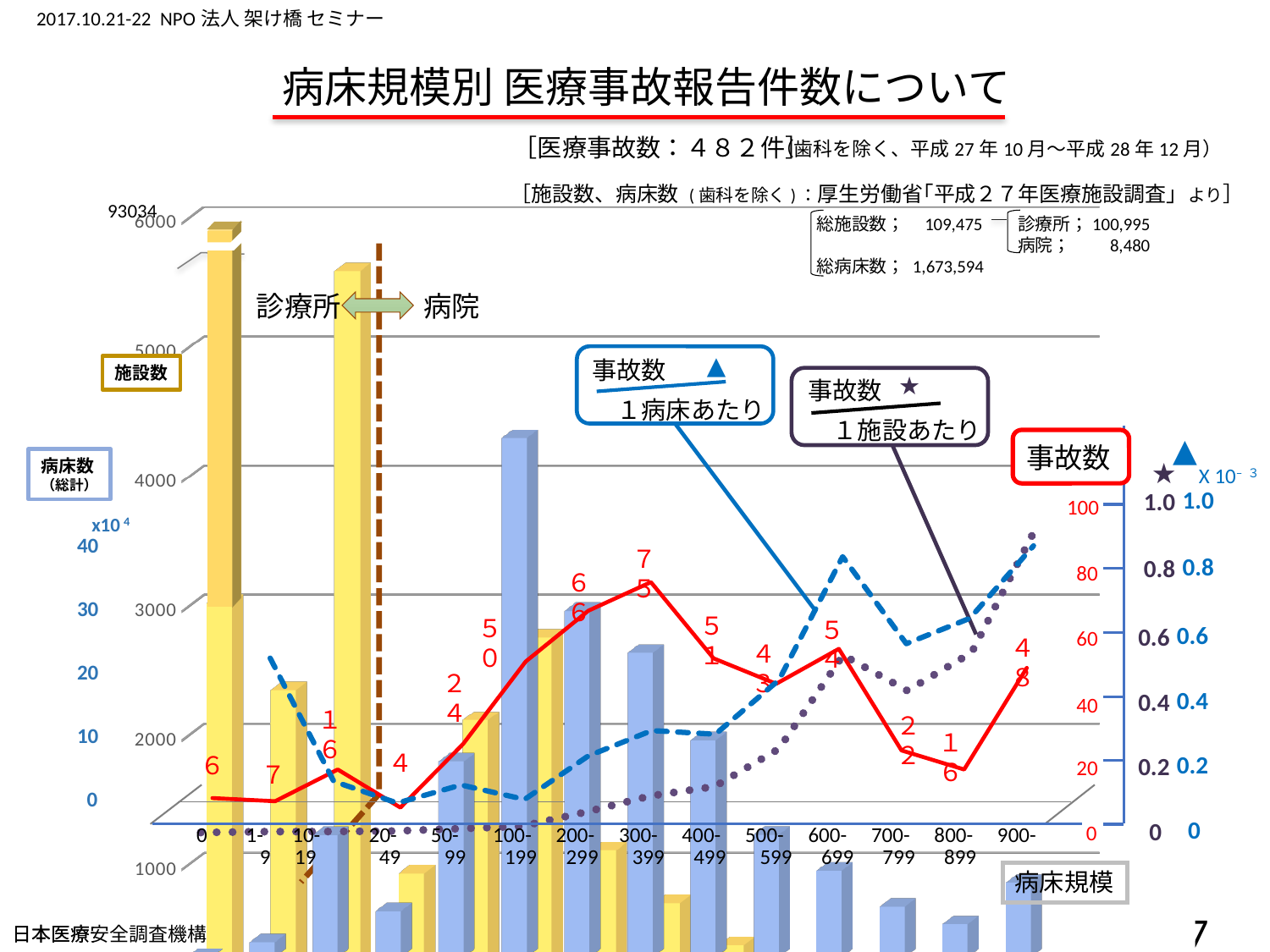
What is the number of medical accidents (事故数) for the 0 bed category? 6 Which bed-size category has the highest number of medical accidents (事故数)? 300-399 Which bed-size category has the lowest number of medical accidents (事故数)? 20-49 What is the difference in the number of medical accidents between the 300-399 and 200-299 bed categories? 9 Does the number of medical accidents rise or fall from the 300-399 category to the 500-599 category? fall What is the number of medical accidents (事故数) for the 300-399 bed category? 75 What is the difference in the number of medical accidents between the 700-799 and 800-899 bed categories? 6 Which has more medical accidents, the 100-199 bed category or the 900- bed category? 100-199 What kind of chart is used to show the number of facilities (施設数) and number of beds (病床数)? bar chart What is the number of medical accidents (事故数) for the 900- bed category? 48 What value is labelled for the number of facilities (施設数) in the 0 bed category? 93034 How many bed-size categories are shown on the x axis? 14